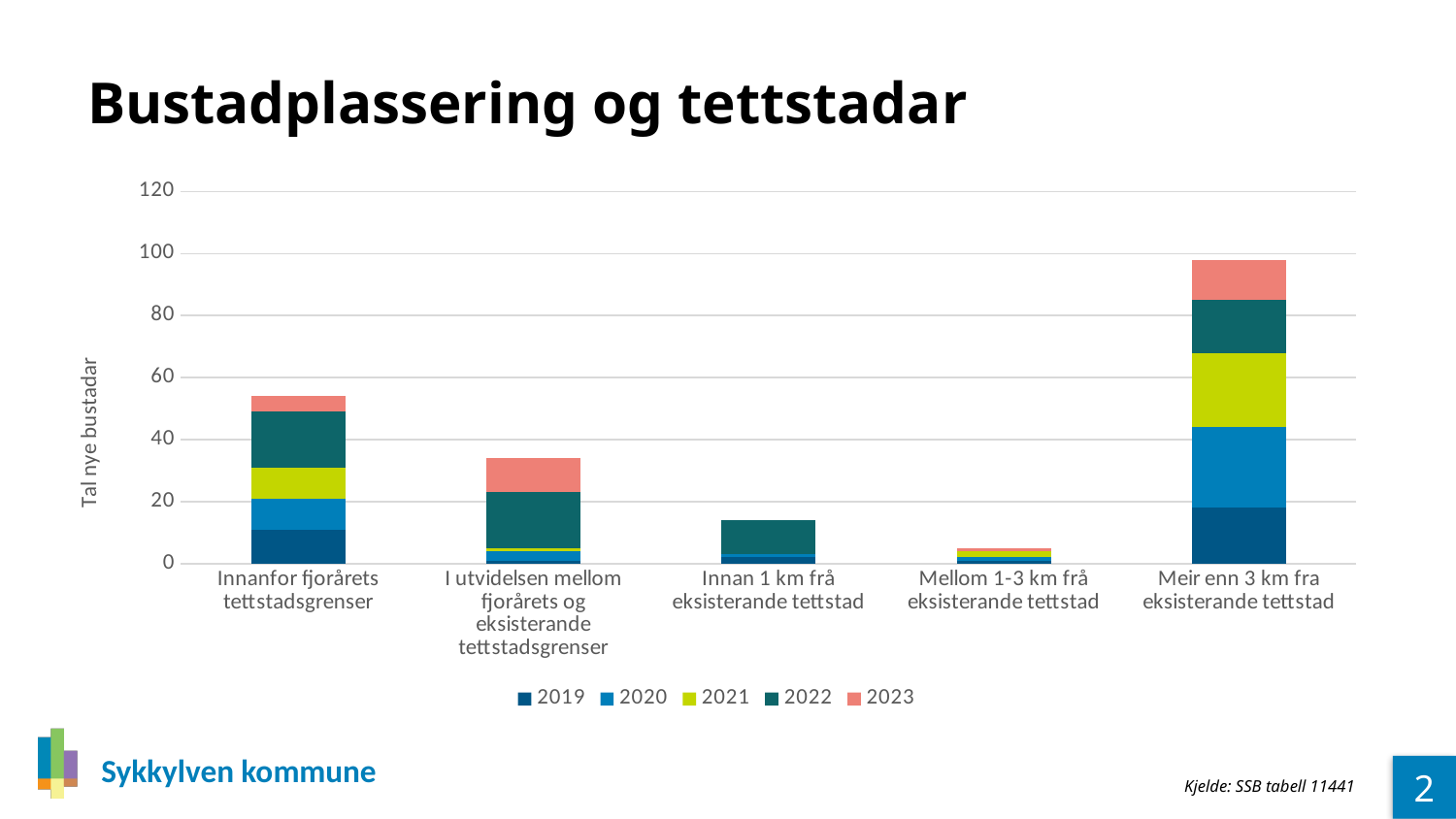
How many series does the legend list? 5 Is the total for 'Innan 1 km frå eksisterande tettstad' greater or less than 20? less What type of chart is shown on the slide? Stacked bar chart Which category has the highest total number of new dwellings? Meir enn 3 km fra eksisterande tettstad Is the total for 'Meir enn 3 km fra eksisterande tettstad' greater or less than 80? greater How many categories are shown on the x axis? 5 Which category has the lowest total number of new dwellings? Mellom 1-3 km frå eksisterande tettstad Is the total for 'I utvidelsen mellom fjorårets og eksisterande tettstadsgrenser' greater or less than 40? less What is the label on the y axis? Tal nye bustadar What is the title of the chart? Bustadplassering og tettstadar Which has a larger total: 'Innanfor fjorårets tettstadsgrenser' or 'I utvidelsen mellom fjorårets og eksisterande tettstadsgrenser'? Innanfor fjorårets tettstadsgrenser